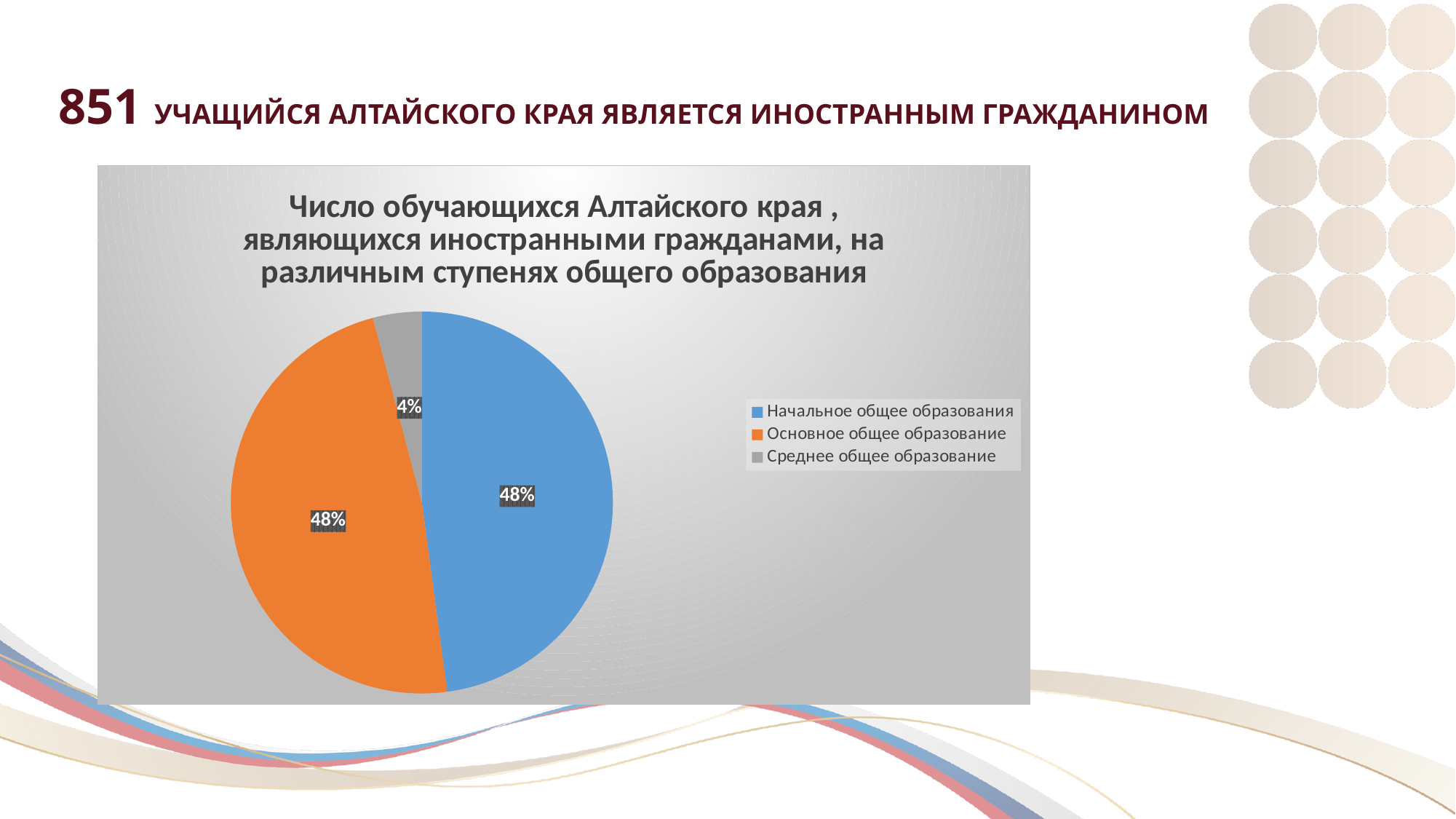
What share of the pie does Основное общее образование have? 48% What share of the pie does Начальное общее образования have? 48% What kind of chart is shown on the slide? Pie chart What is the combined share of Начальное общее образования and Основное общее образование? 96% How many slices does the pie chart have? 3 What share of the pie does Среднее общее образование have? 4% By how many percentage points does the Основное общее образование slice exceed the Среднее общее образование slice? 44 Which is larger: the slice for Начальное общее образования or the slice for Среднее общее образование? Начальное общее образования How many entries does the legend list? 3 What is the title of the chart? Число обучающихся Алтайского края , являющихся иностранными гражданами, на различным ступенях общего образования Which colour represents Основное общее образование in the pie chart? Orange Which category has the smallest slice of the pie? Среднее общее образование